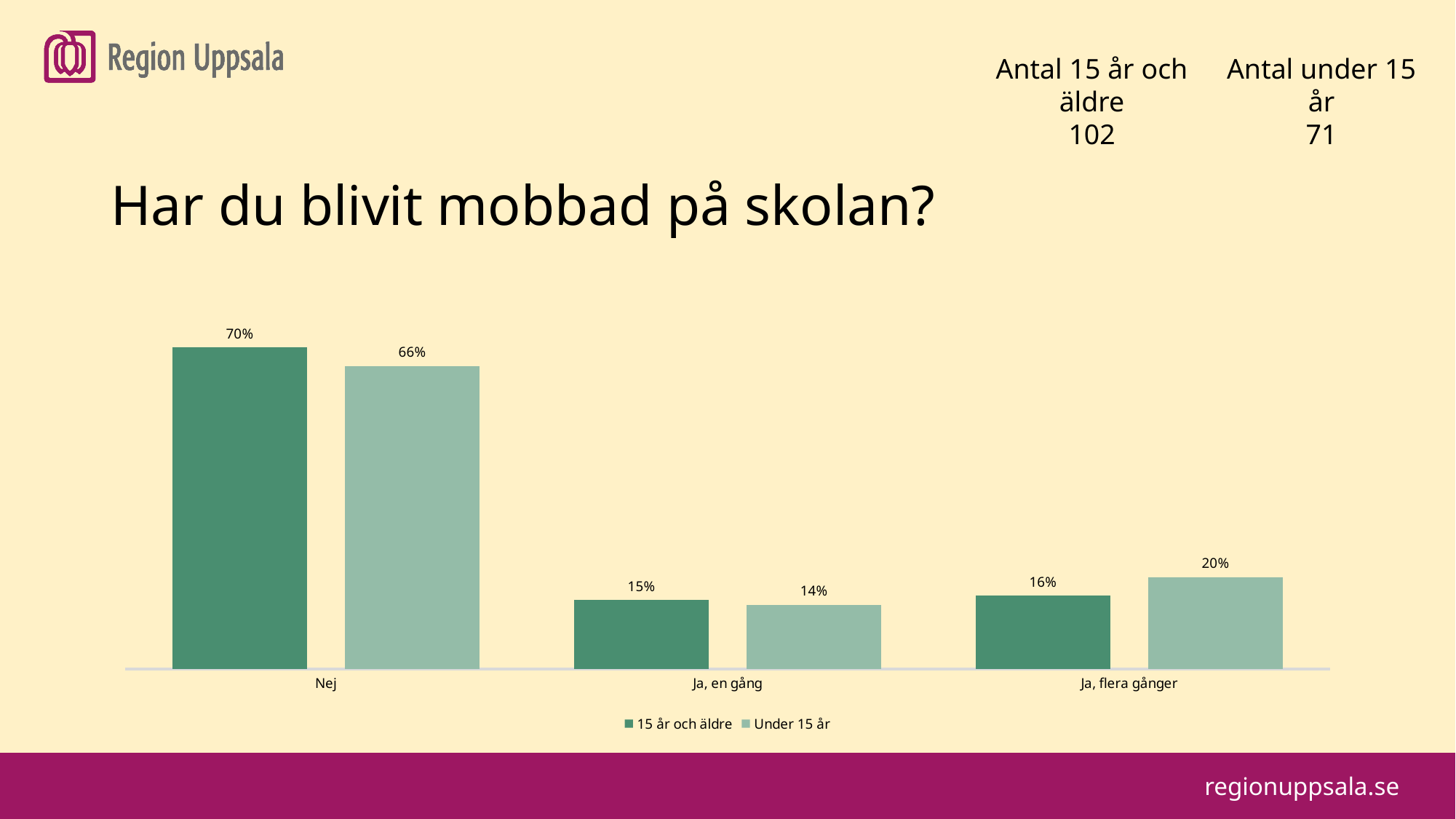
Which category has the lowest value for the "Under 15 år" series? Ja, en gång What is the value for "Under 15 år" in the "Ja, en gång" category? 14% What is the title of the chart? Har du blivit mobbad på skolan? What is the difference between the "15 år och äldre" and "Under 15 år" values in the "Ja, flera gånger" category? 4% How many series does the legend list? 2 What is the difference between the "15 år och äldre" and "Under 15 år" values in the "Nej" category? 4% How many categories are shown on the x axis? 3 In the "Ja, flera gånger" category, which series has the larger value? Under 15 år What is the value for "Under 15 år" in the "Ja, flera gånger" category? 20% Which category has the highest value for the "15 år och äldre" series? Nej What is the value for "15 år och äldre" in the "Nej" category? 70% What kind of chart is shown on the slide? Bar chart